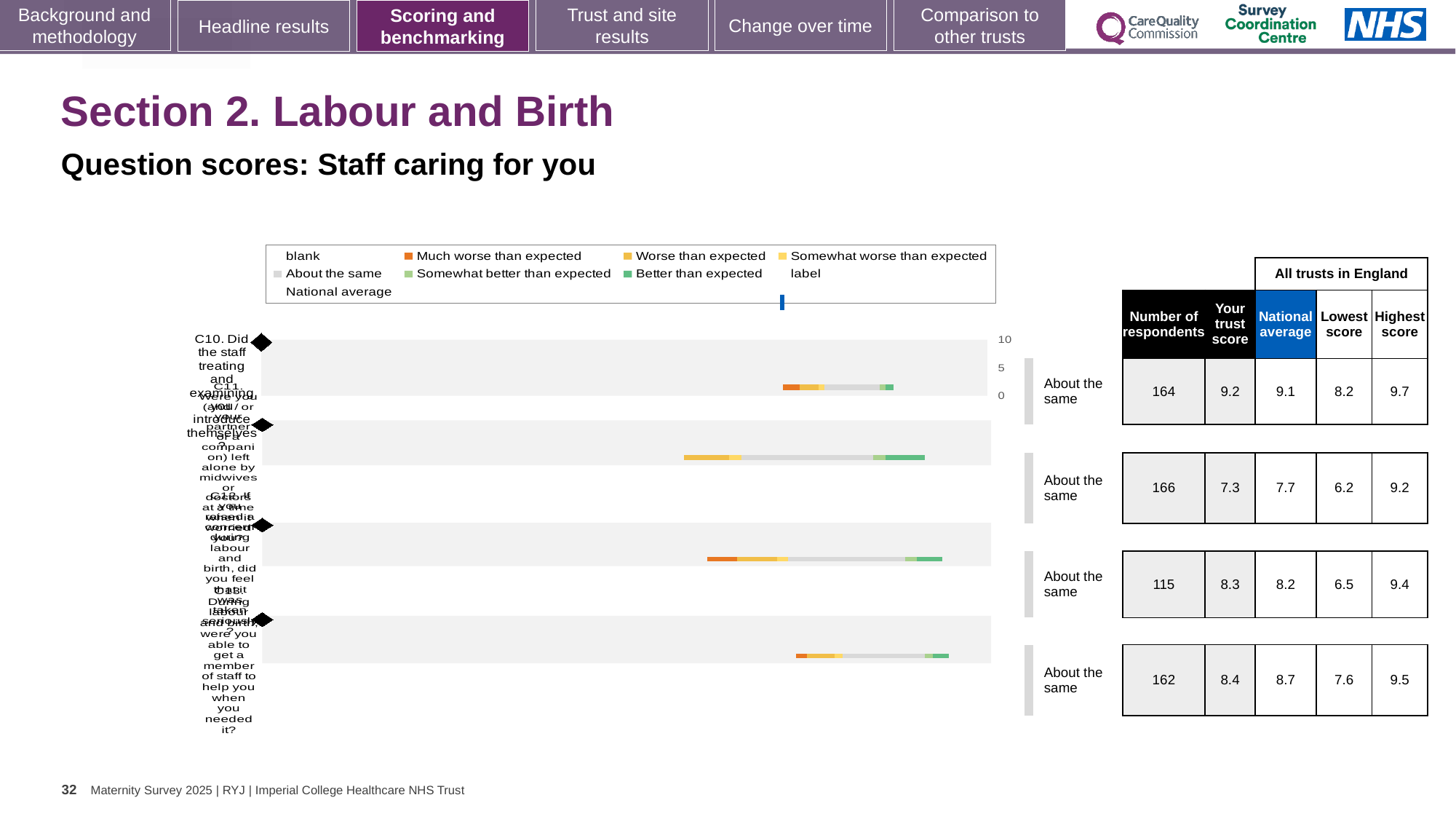
In the chart legend, what colour represents 'Better than expected'? green In the first row of the table beside the chart, what is the difference between the highest score and the lowest score? 1.5 Which row of the table beside the chart has the highest number of respondents? the second row (166) In the table beside the chart, what is the national average in the fourth row? 8.7 In the table beside the chart, what is the highest score in the third row? 9.4 In the second row of the table beside the chart, which is larger: the trust score or the national average? the national average (7.7) In the table beside the chart, what is the 'Your trust score' value in the second row? 7.3 What kind of chart is shown on the slide? bar chart In the table beside the chart, what is the number of respondents in the first row? 164 How many question bars are plotted in the chart? 4 In the chart legend, what colour represents 'Much worse than expected'? orange Which row of the table beside the chart has the lowest number of respondents? the third row (115)